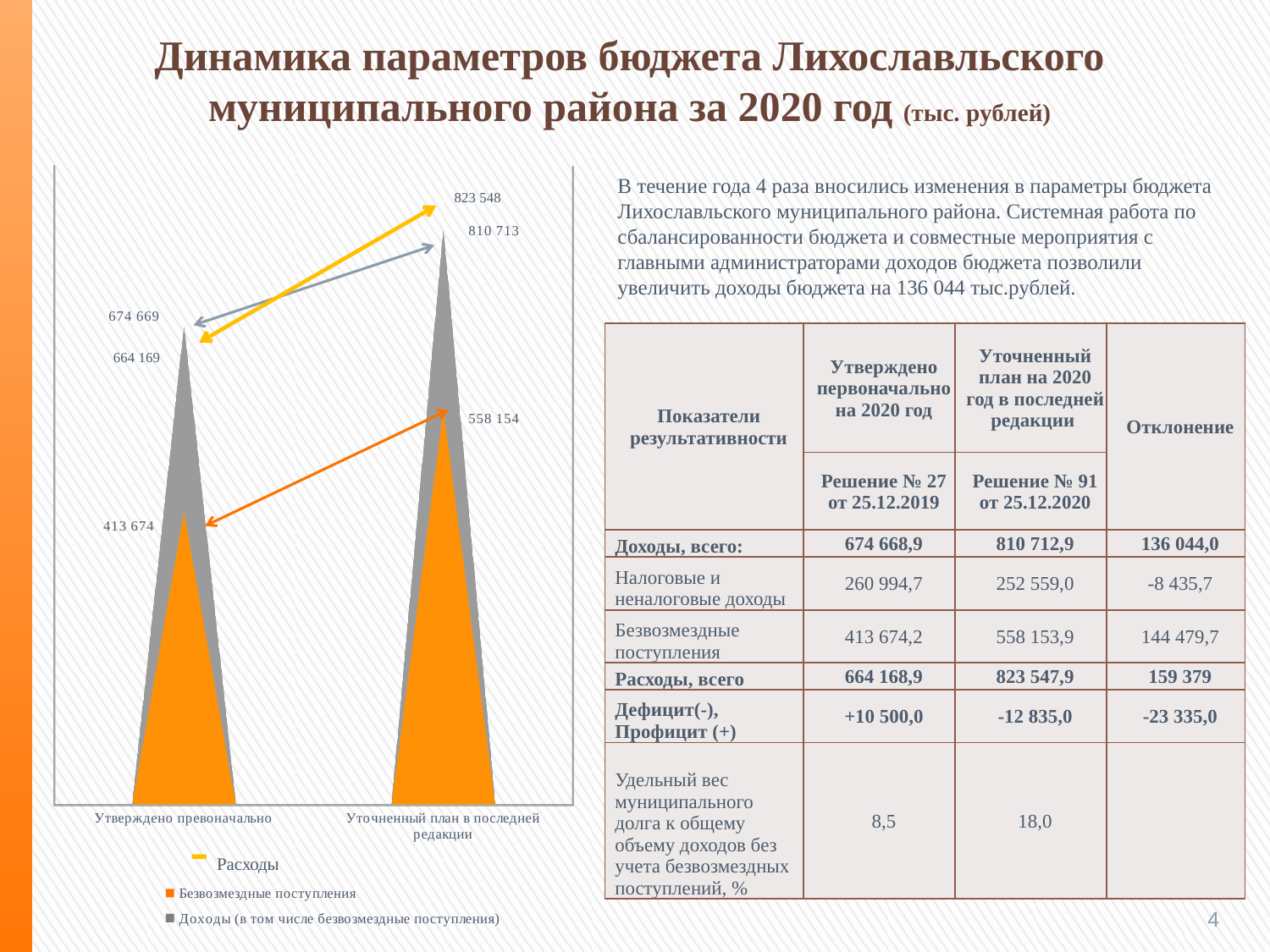
What is the value of Безвозмездные поступления for Уточненный план в последней редакции? 558 154 What is the value of Расходы for Уточненный план в последней редакции? 823 548 What is the value of Безвозмездные поступления for Утверждено превоначально? 413 674 For Уточненный план в последней редакции, which is larger: Расходы or Доходы (в том числе безвозмездные поступления)? Расходы How many series does the chart legend list? 3 How many categories are shown on the x axis of the chart? 2 What is the value of Доходы (в том числе безвозмездные поступления) for Утверждено превоначально? 674 669 Do the values of Доходы rise or fall from Утверждено превоначально to Уточненный план в последней редакции? rise What is the difference between Расходы and Доходы for Уточненный план в последней редакции? 12 835 What kind of chart is shown on the slide? bar chart By how much did Безвозмездные поступления increase from Утверждено превоначально to Уточненный план в последней редакции? 144 480 What is the value of Расходы for Утверждено превоначально? 664 169